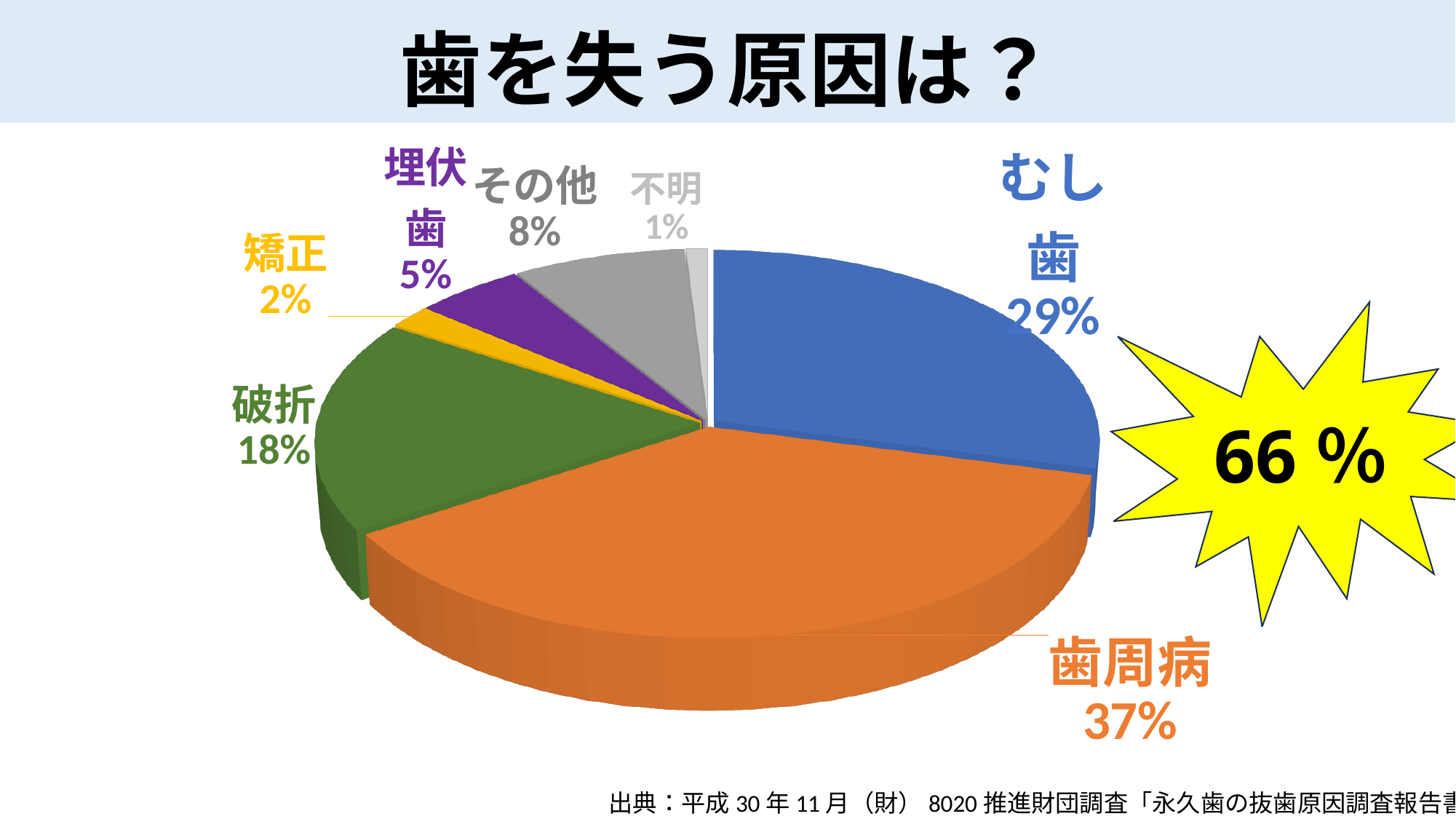
What is the share for 埋伏歯? 5% Which is larger, the share for その他 or the share for 矯正? その他 What is the share for むし歯? 29% Which category has the largest share of the pie? 歯周病 How many categories are shown in the pie chart? 7 Which category has the smallest share of the pie? 不明 What is the title of the slide containing the chart? 歯を失う原因は？ What is the share for 破折? 18% What is the share for 不明? 1% What is the share for 歯周病? 37% What is the difference between the shares of 歯周病 and むし歯? 8% What kind of chart is shown on the slide? pie chart